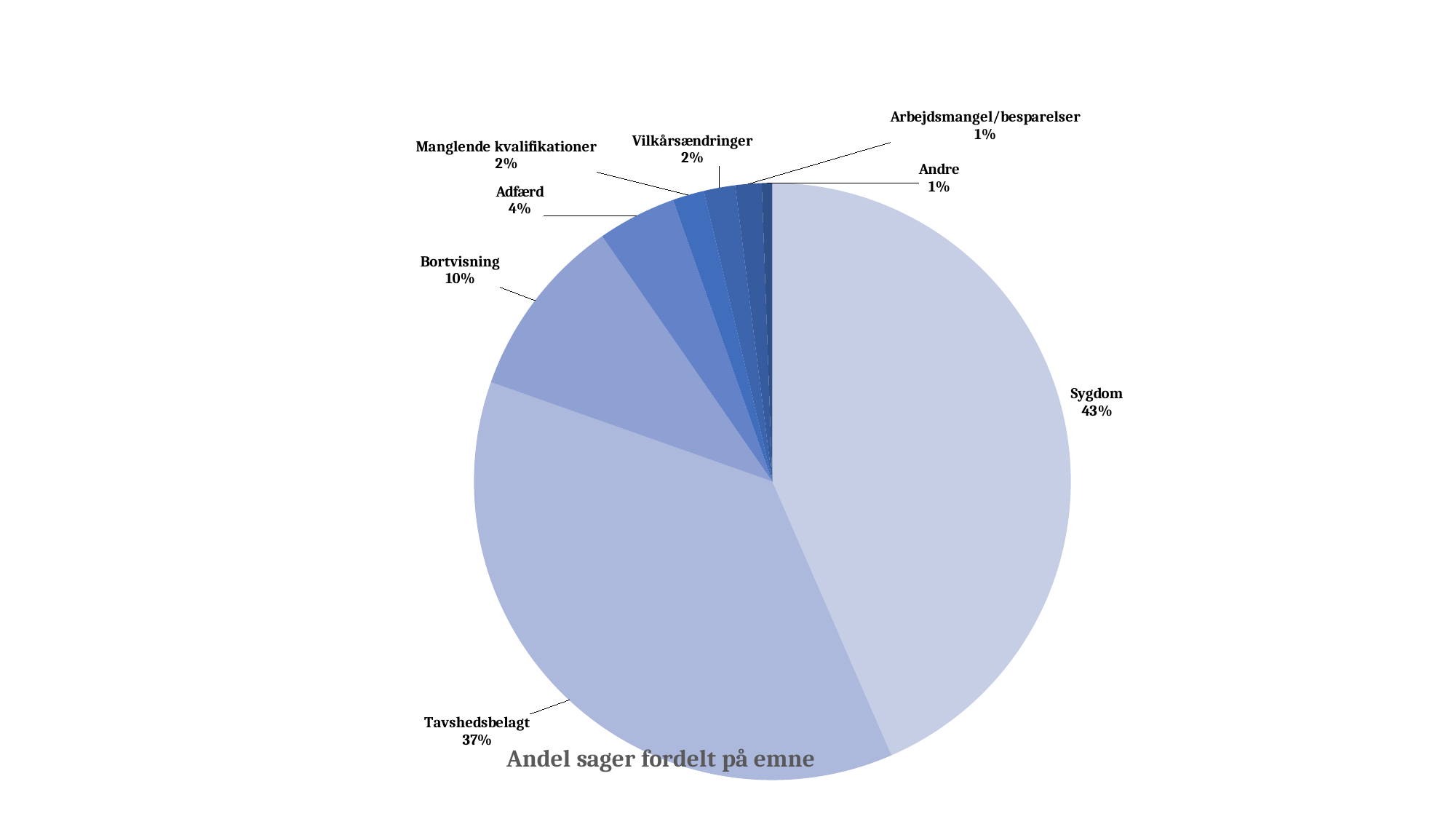
Which is larger, Bortvisning or Adfærd? Bortvisning What share of the pie does Tavshedsbelagt have? 37% What is the difference between the shares of Bortvisning and Manglende kvalifikationer? 8% What is the value for Bortvisning? 10% Which category has the largest slice? Sygdom What is the difference between the shares of Sygdom and Tavshedsbelagt? 6% What is the title of the chart? Andel sager fordelt på emne What kind of chart is shown on the slide? pie chart What share of the pie does Sygdom have? 43% What is the value for Arbejdsmangel/besparelser? 1% How many categories are shown in the pie chart? 8 What is the value for Adfærd? 4%